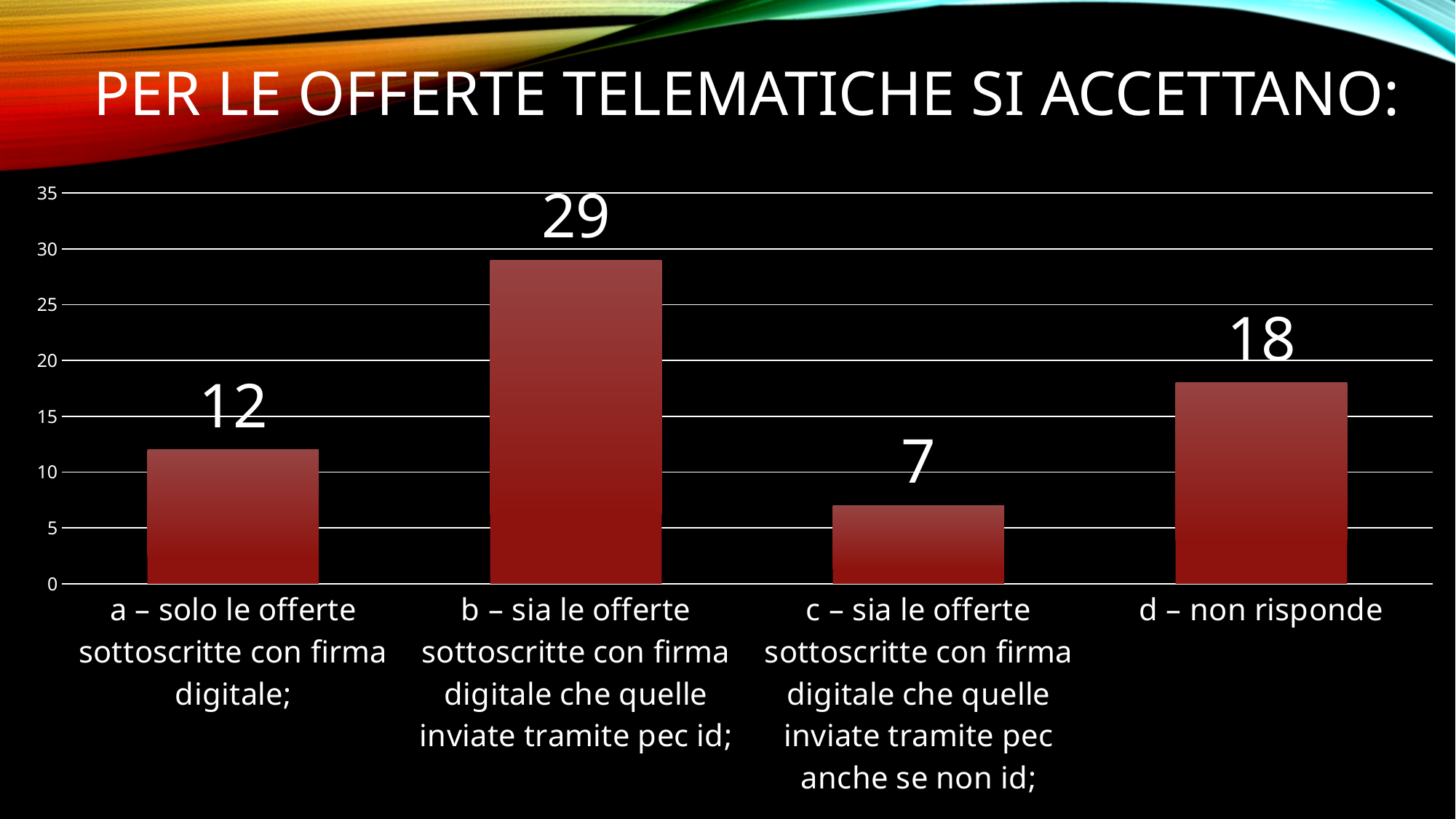
What is the value for 'a – solo le offerte sottoscritte con firma digitale;'? 12 What is the value for 'b – sia le offerte sottoscritte con firma digitale che quelle inviate tramite pec id;'? 29 What is the difference between the values for category b and category d? 11 What is the difference between the values for category a and category c? 5 What is the value for 'c – sia le offerte sottoscritte con firma digitale che quelle inviate tramite pec anche se non id;'? 7 What is the title of the slide? PER LE OFFERTE TELEMATICHE SI ACCETTANO: What kind of chart is shown on the slide? Bar chart Which category has the highest value? b – sia le offerte sottoscritte con firma digitale che quelle inviate tramite pec id; Which is larger, the value for 'a – solo le offerte sottoscritte con firma digitale;' or the value for 'd – non risponde'? d – non risponde Which category has the lowest value? c – sia le offerte sottoscritte con firma digitale che quelle inviate tramite pec anche se non id; How many categories are shown in the chart? 4 What is the value for 'd – non risponde'? 18